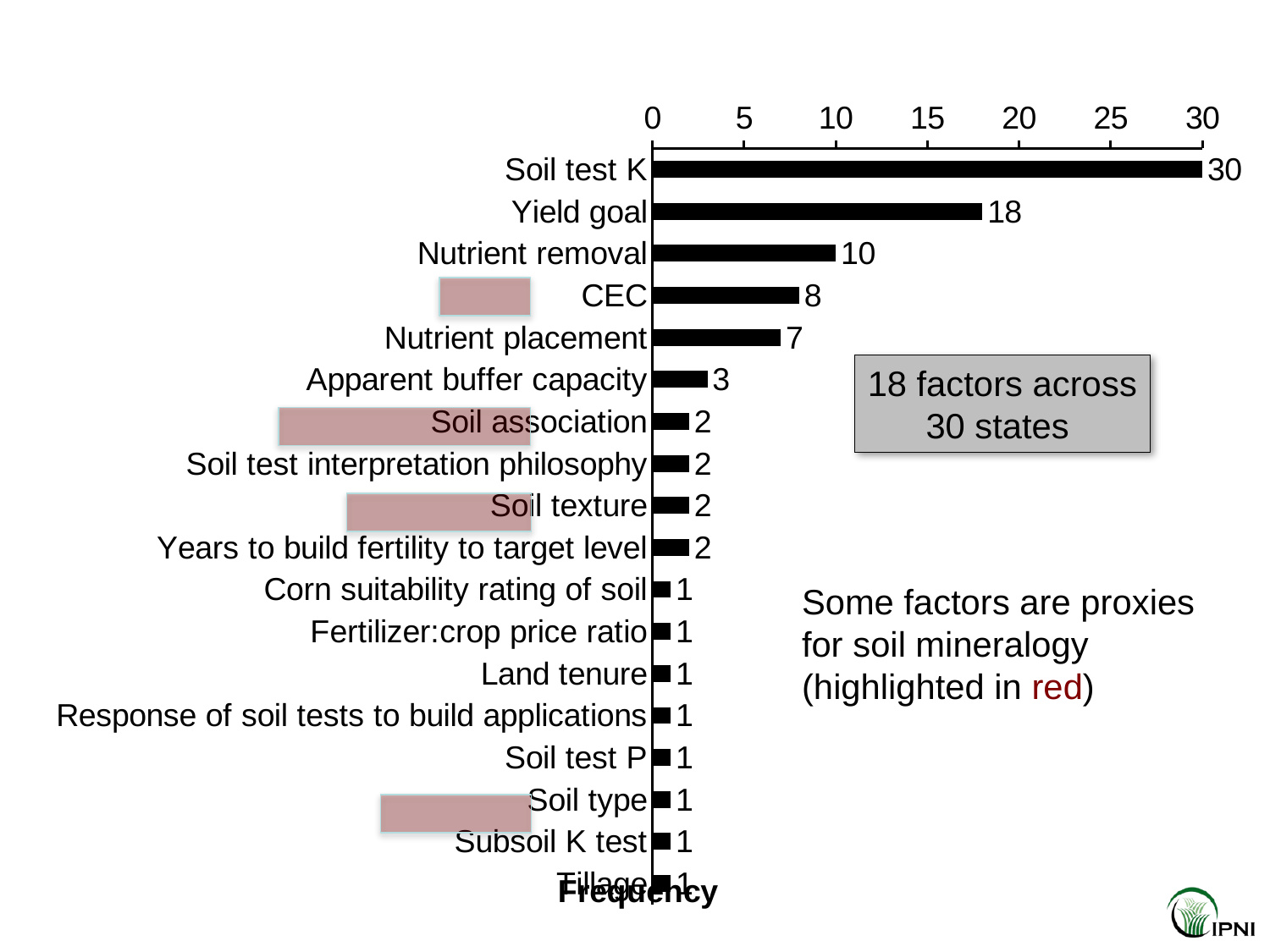
What is the label of the horizontal axis? Frequency Which has a higher frequency, Nutrient removal or CEC? Nutrient removal What is the frequency value for Apparent buffer capacity? 3 What is the frequency value for Yield goal? 18 What kind of chart is shown on the slide? bar chart What is the frequency value for CEC? 8 What is the frequency value for Soil test K? 30 Is the frequency for Yield goal greater or less than 15? greater How many factors (categories) are plotted in the chart? 18 What is the difference in frequency between Soil test K and Yield goal? 12 Which factor has the highest frequency? Soil test K What is the difference in frequency between Nutrient removal and Nutrient placement? 3